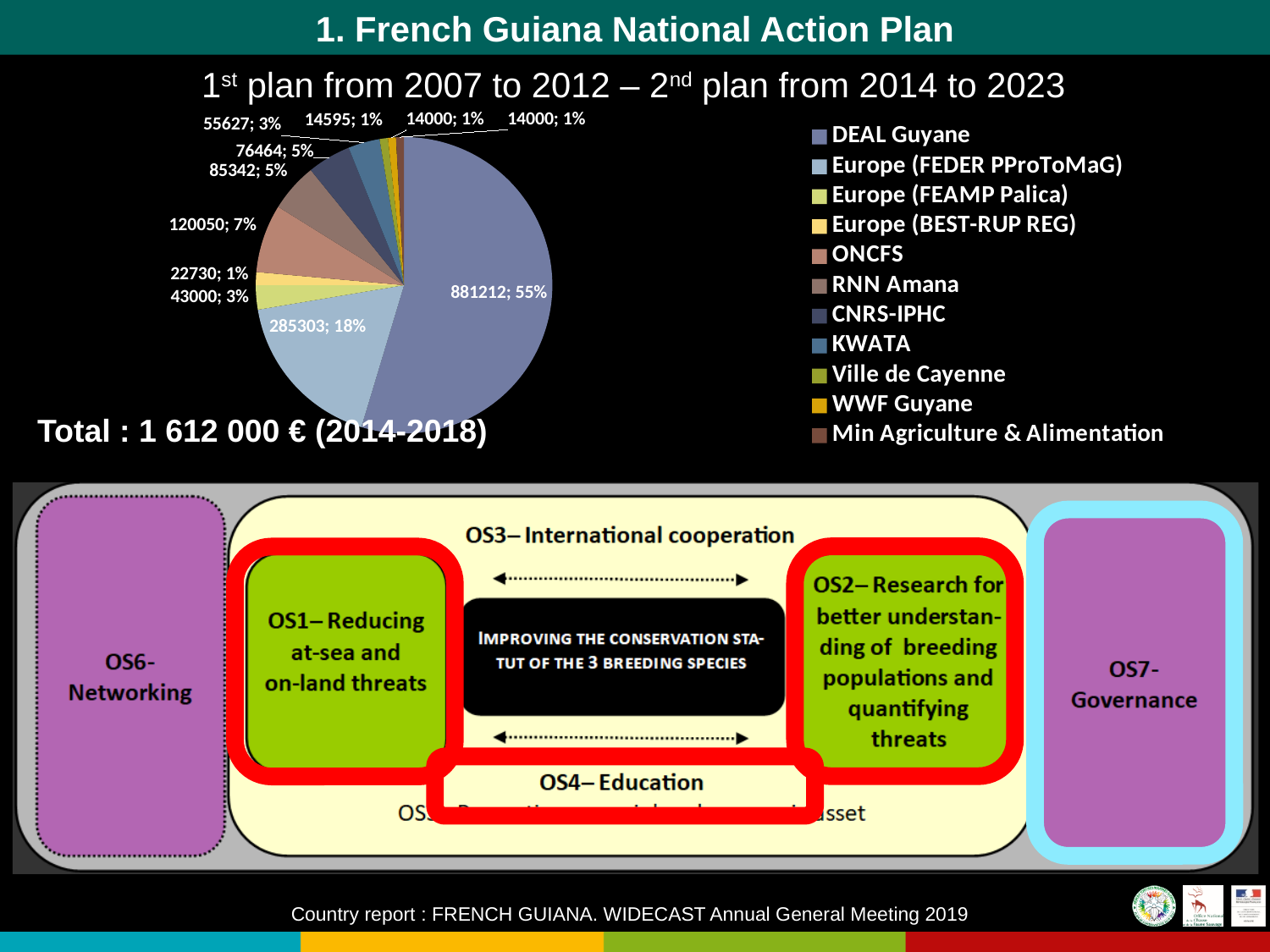
What share of the pie does the DEAL Guyane slice represent? 55% What is the difference between the values labelled 881212 and 285303 on the pie chart? 595909 Which is larger, the DEAL Guyane slice or the Europe (FEDER PProToMaG) slice? DEAL Guyane What value is labelled on the Europe (FEDER PProToMaG) slice? 285303 How many entries does the legend of the pie chart list? 11 How many slices of the pie chart are labelled with 1%? 4 Which funder has the largest slice of the pie chart? DEAL Guyane What percentage is shown for the Europe (FEDER PProToMaG) slice? 18% What type of chart is shown on the slide? pie chart What percentage is shown for the slice labelled 120050? 7% What total amount is stated below the pie chart? 1 612 000 € (2014-2018) What value is labelled on the largest slice of the pie chart? 881212